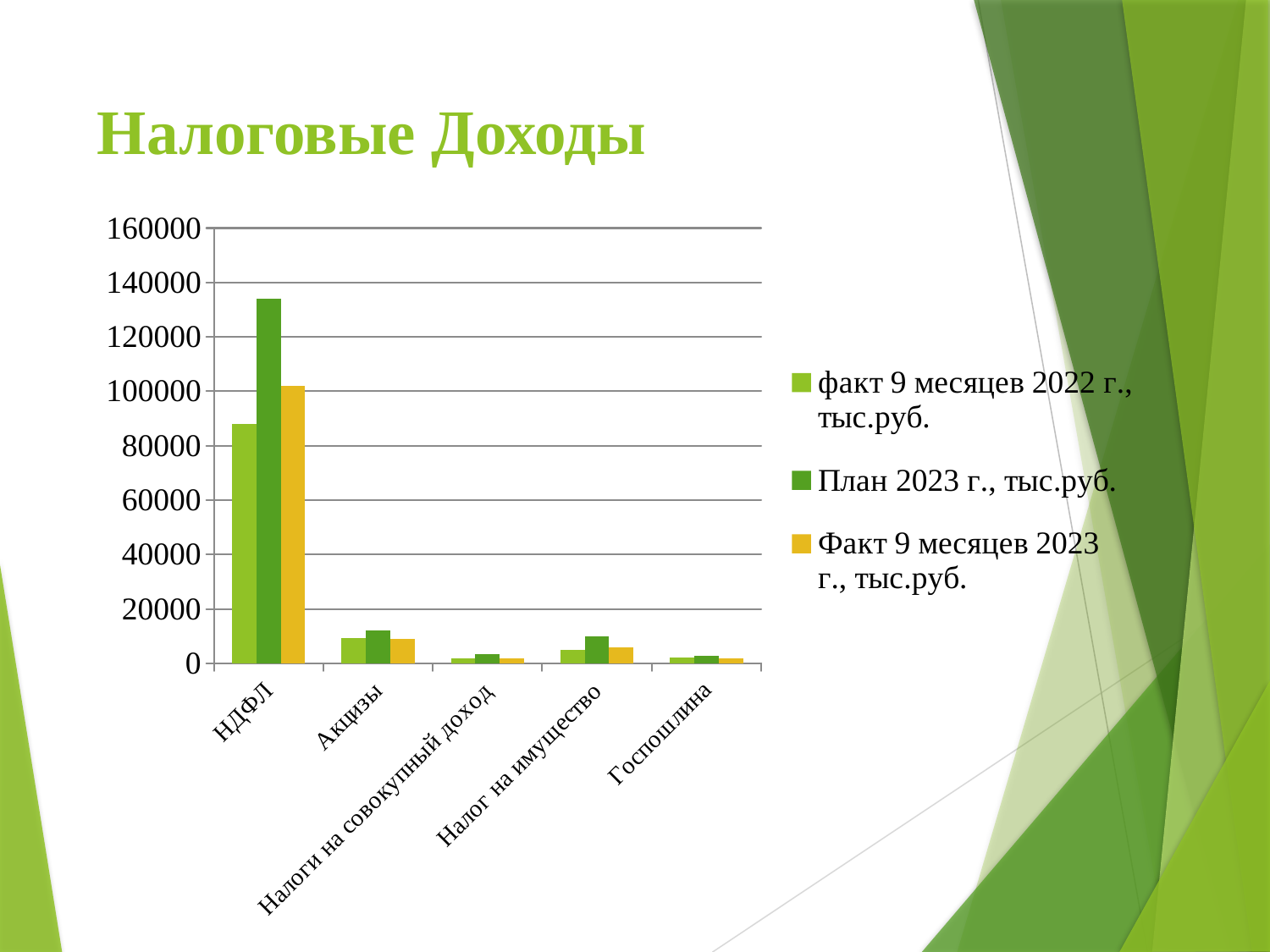
Is the value for НДФЛ in the series "План 2023 г., тыс.руб." greater or less than 120000? greater What is the title of the slide containing the chart? Налоговые Доходы For НДФЛ, which is larger: the value for "План 2023 г., тыс.руб." or the value for "Факт 9 месяцев 2023 г., тыс.руб."? План 2023 г., тыс.руб. In the series "факт 9 месяцев 2022 г., тыс.руб.", which is larger: Акцизы or Госпошлина? Акцизы Is the value for НДФЛ in the series "Факт 9 месяцев 2023 г., тыс.руб." greater or less than 80000? greater Is the value for НДФЛ in the series "факт 9 месяцев 2022 г., тыс.руб." greater or less than 100000? less How many categories are shown on the x axis of the chart? 5 What colour represents the series "Факт 9 месяцев 2023 г., тыс.руб." in the chart? Yellow How many series does the legend list? 3 Which category has the highest value for the series "План 2023 г., тыс.руб."? НДФЛ What kind of chart is shown on the slide? Bar chart